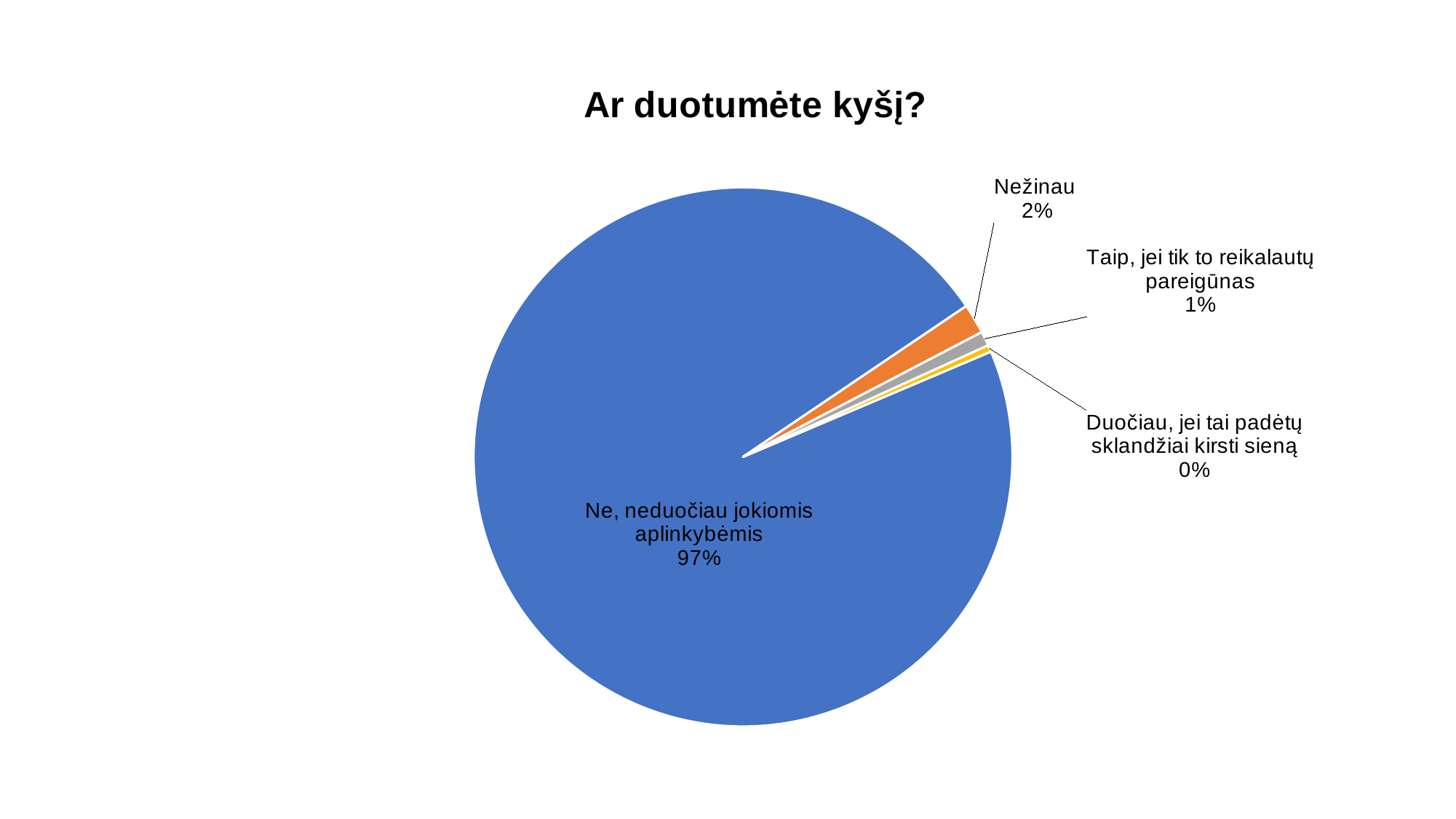
What is the difference in percentage points between "Ne, neduočiau jokiomis aplinkybėmis" and "Nežinau"? 95 percentage points What colour is the slice for "Ne, neduočiau jokiomis aplinkybėmis"? blue Which category has the largest slice of the pie? Ne, neduočiau jokiomis aplinkybėmis What share of the pie is labelled "Nežinau"? 2% What is the title of the chart? Ar duotumėte kyšį? Which category has the smallest slice of the pie? Duočiau, jei tai padėtų sklandžiai kirsti sieną What kind of chart is shown on the slide? pie chart How many categories are shown in the pie chart? 4 What share of the pie is labelled "Taip, jei tik to reikalautų pareigūnas"? 1% What share of the pie is labelled "Duočiau, jei tai padėtų sklandžiai kirsti sieną"? 0% Which is larger, the slice for "Nežinau" or the slice for "Taip, jei tik to reikalautų pareigūnas"? Nežinau